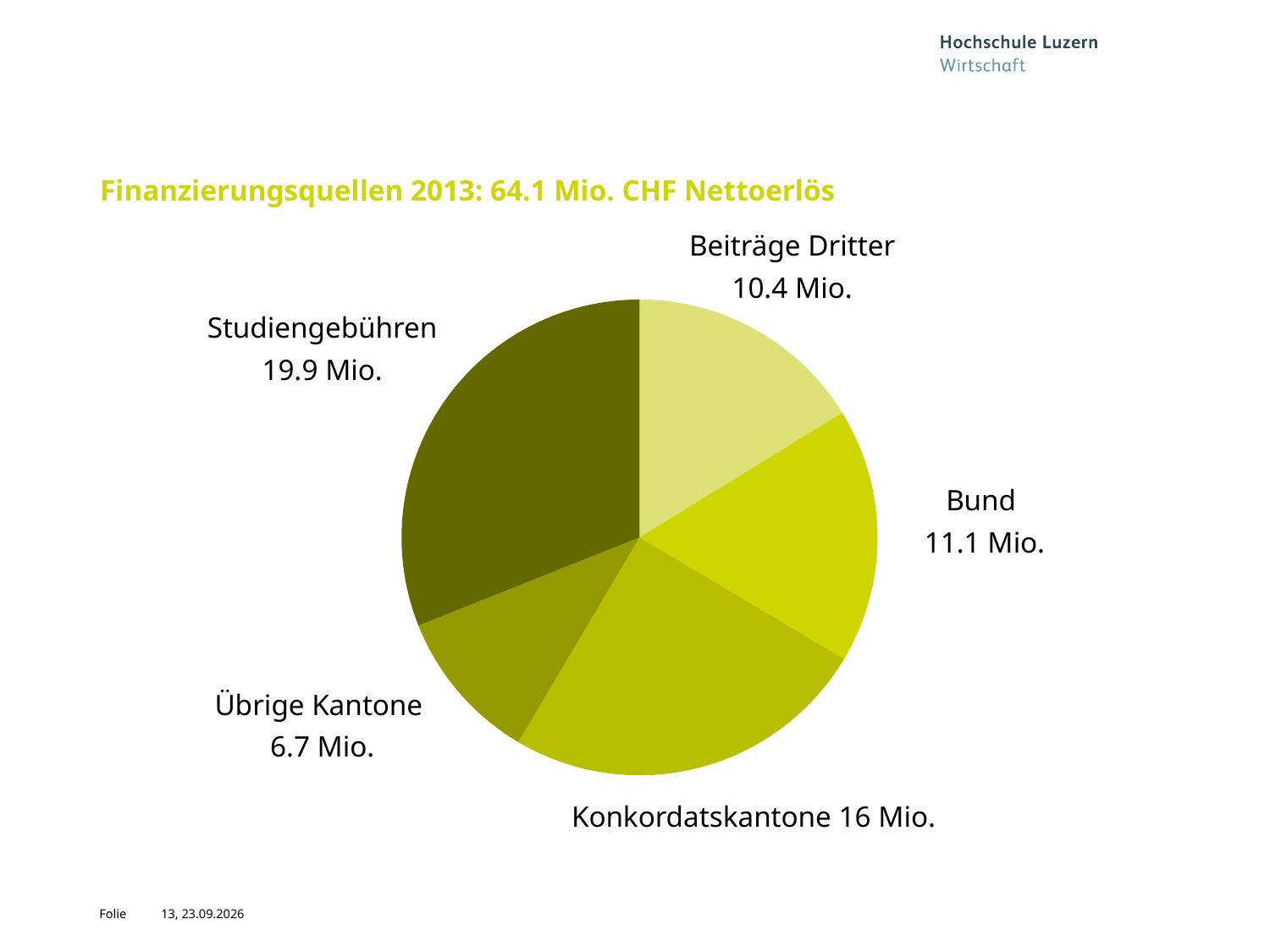
What is the value for Studiengebühren? 19.9 Mio. What is the value for Konkordatskantone? 16 Mio. Which funding source has the smallest slice of the pie? Übrige Kantone What is the total net revenue stated in the chart title? 64.1 Mio. CHF What is the value for Übrige Kantone? 6.7 Mio. Which is larger, Bund or Beiträge Dritter? Bund How many slices does the pie chart have? 5 What type of chart is shown on the slide? Pie chart What is the value for Bund? 11.1 Mio. What is the difference between Studiengebühren and Übrige Kantone? 13.2 Mio. Which funding source has the largest slice of the pie? Studiengebühren What is the difference between Konkordatskantone and Bund? 4.9 Mio.